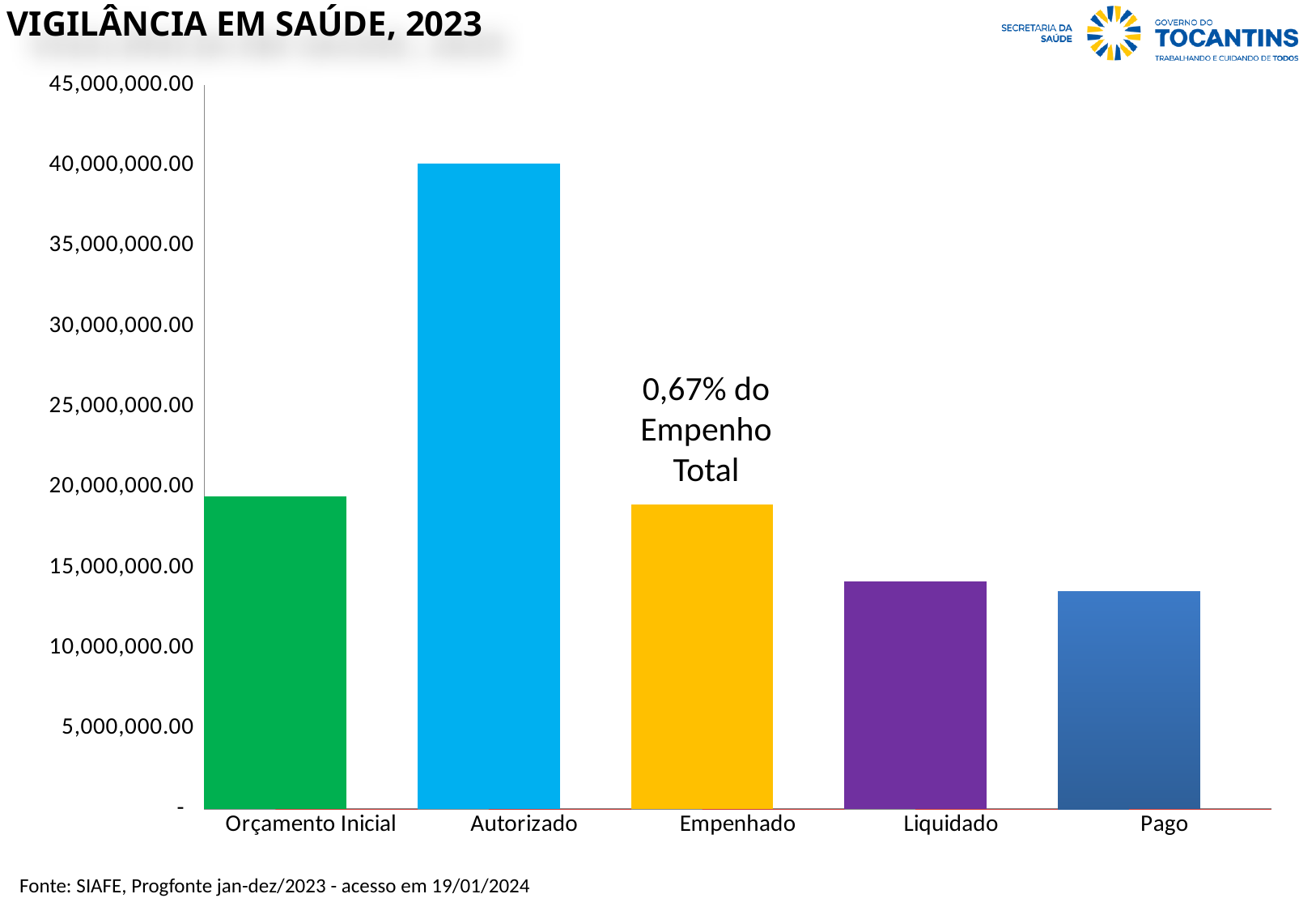
What text annotation appears above the Empenhado bar? 0,67% do Empenho Total Which is larger, the value for Autorizado or the value for Orçamento Inicial? Autorizado What kind of chart is shown on the slide? bar chart Which category has the lowest value? Pago Which category has the highest value? Autorizado Is the value for Orçamento Inicial greater or less than 20,000,000.00? less How many categories are plotted on the x axis? 5 Is the value for Liquidado greater or less than 15,000,000.00? less Is the value for Pago greater or less than 10,000,000.00? greater What is the title of the chart? VIGILÂNCIA EM SAÚDE, 2023